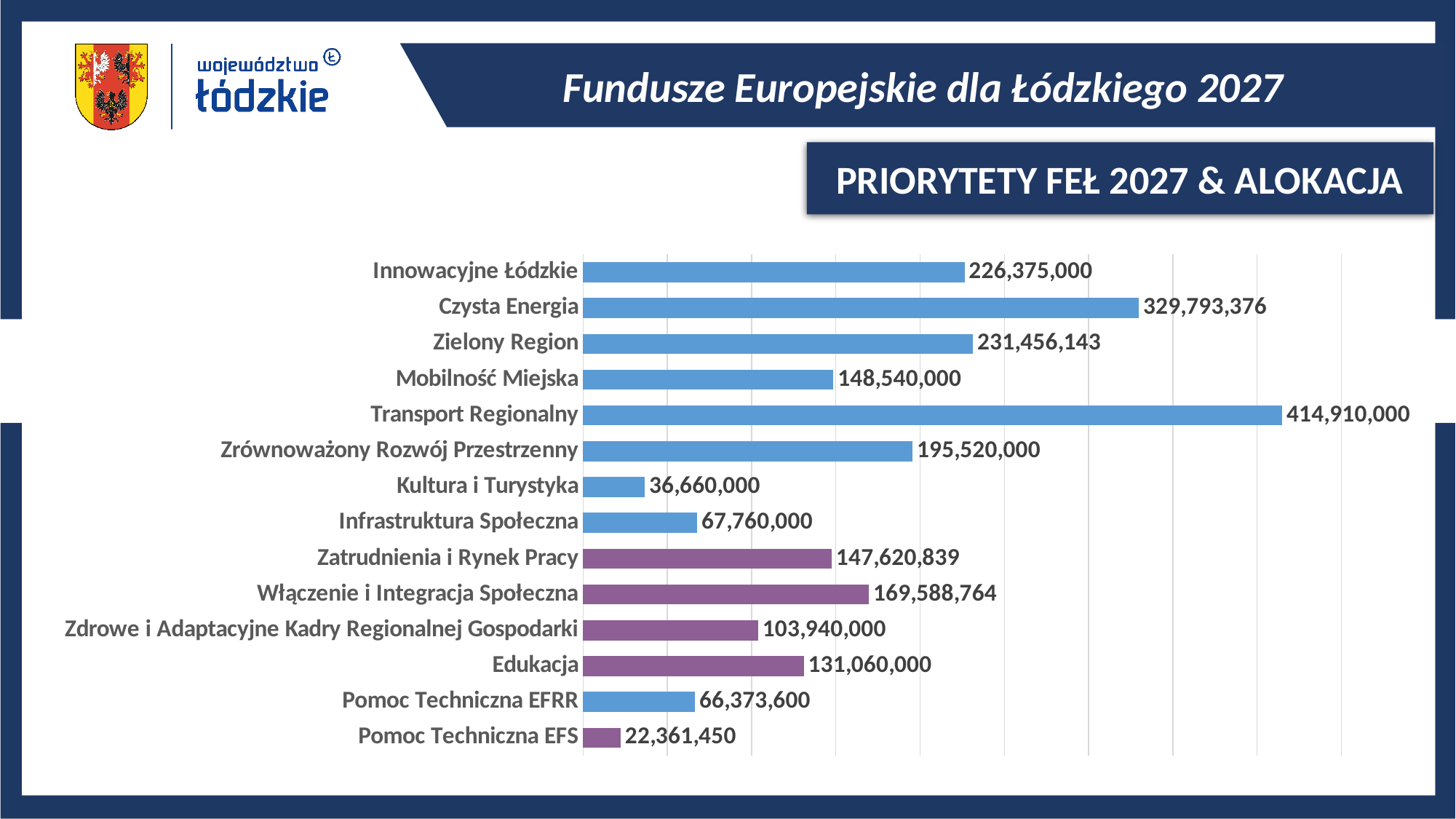
Which category has the lowest value? Pomoc Techniczna EFS What is the value for Włączenie i Integracja Społeczna? 169,588,764 How many categories are shown in the chart? 14 What is the value for Pomoc Techniczna EFRR? 66,373,600 What kind of chart is shown on the slide? Bar chart What is the difference between the values for Pomoc Techniczna EFRR and Pomoc Techniczna EFS? 44,012,150 What is the value for Kultura i Turystyka? 36,660,000 Which category has the highest value? Transport Regionalny What is the value for Transport Regionalny? 414,910,000 What is the difference between the values for Transport Regionalny and Czysta Energia? 85,116,624 What colour is the bar for Edukacja? Purple Which is larger, the value for Czysta Energia or the value for Zielony Region? Czysta Energia